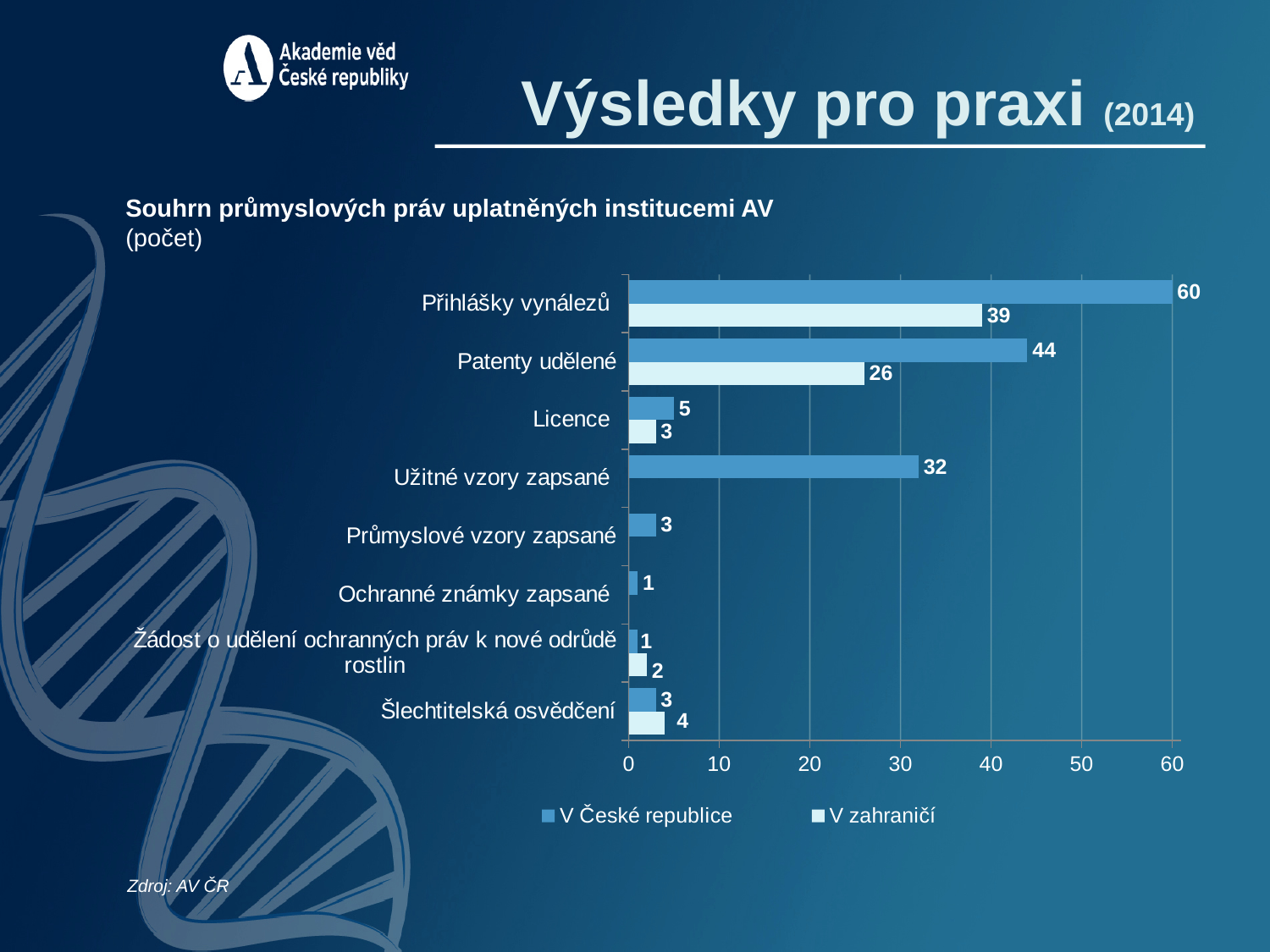
What is the difference between the V České republice values for Patenty udělené and Užitné vzory zapsané? 12 Which category has the lowest value in the V zahraničí series among those with a labelled bar? Žádost o udělení ochranných práv k nové odrůdě rostlin How many categories are shown on the chart? 8 What is the difference between the V České republice and V zahraničí values for Přihlášky vynálezů? 21 Which category has the highest value in the V České republice series? Přihlášky vynálezů What is the value for Patenty udělené in the V zahraničí series? 26 What is the title of the chart? Souhrn průmyslových práv uplatněných institucemi AV (počet) What is the value for Užitné vzory zapsané in the V České republice series? 32 How many series does the legend list? 2 What kind of chart is shown on the slide? Bar chart What is the value for Přihlášky vynálezů in the V České republice series? 60 For Šlechtitelská osvědčení, which series has the larger value, V České republice or V zahraničí? V zahraničí